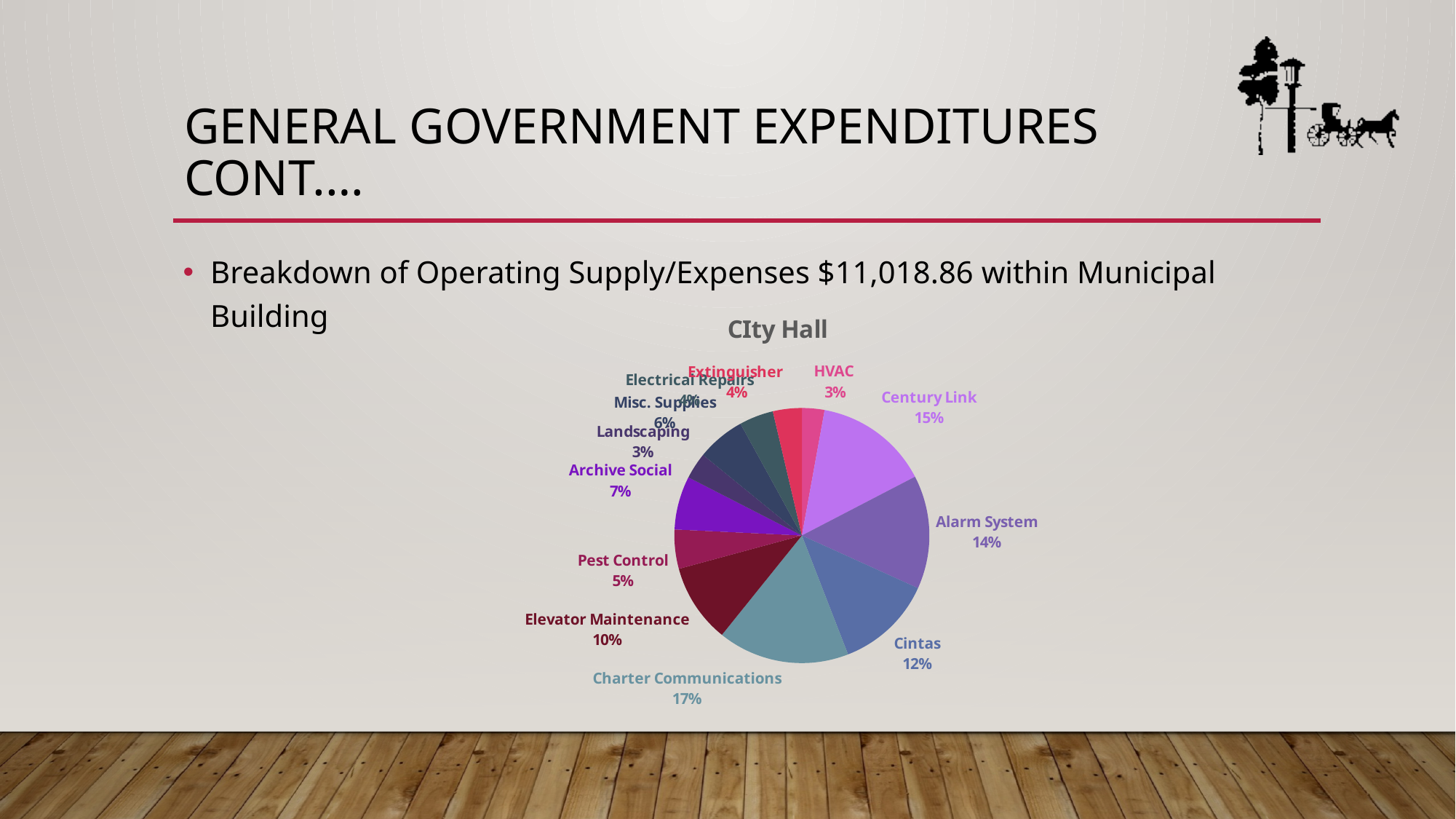
What share of the pie does Century Link represent? 15% What share of the pie does Charter Communications represent? 17% What is the title of the chart? CIty Hall What is the value shown for Elevator Maintenance? 10% How many slices does the pie chart have? 12 Which category has the largest slice of the pie? Charter Communications What type of chart is shown on the slide? pie chart What is the difference between the Century Link share and the Cintas share? 3% What is the value shown for Alarm System? 14% Which is larger, the slice for Cintas or the slice for Pest Control? Cintas What is the value shown for Archive Social? 7% What is the value shown for Misc. Supplies? 6%